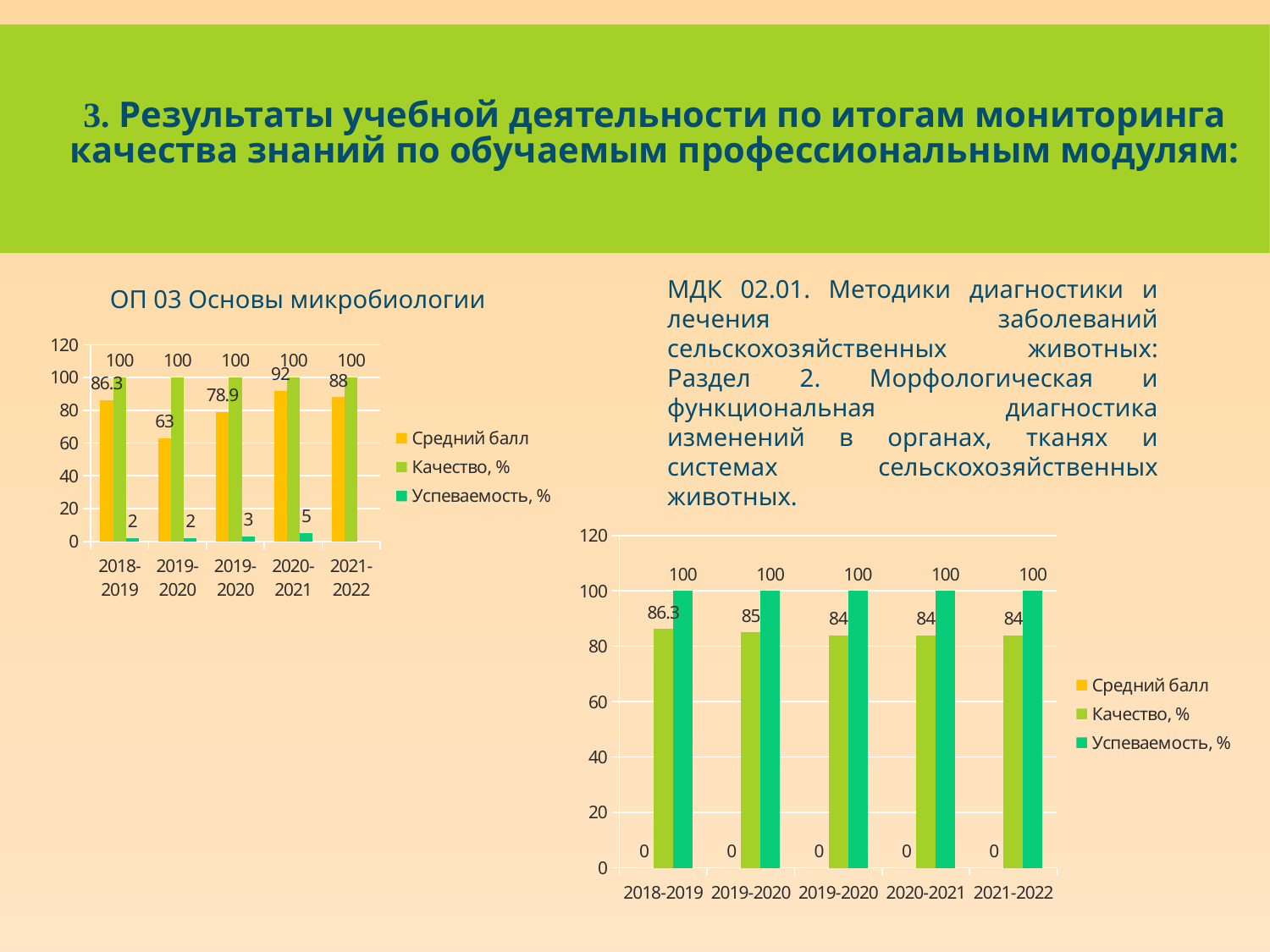
In the chart on the right side of the slide, what is the value of 'Качество, %' for 2018-2019? 86.3 In the chart on the right side of the slide, which is larger: 'Качество, %' for 2018-2019 or for 2021-2022? 2018-2019 In the chart titled 'ОП 03 Основы микробиологии', what is the difference between 'Средний балл' for 2020-2021 and for 2021-2022? 4 In the chart titled 'ОП 03 Основы микробиологии', how many series does the legend list? 3 In the chart on the right side of the slide, how many periods are shown on the x axis? 5 In the chart on the right side of the slide, what is the value of 'Успеваемость, %' for 2021-2022? 100 In the chart on the right side of the slide, what is the value of 'Средний балл' for 2018-2019? 0 In the chart titled 'ОП 03 Основы микробиологии', what is the value of 'Успеваемость, %' for 2020-2021? 5 What type of chart is the chart titled 'ОП 03 Основы микробиологии'? Bar chart In the chart titled 'ОП 03 Основы микробиологии', what is the value of 'Средний балл' for 2020-2021? 92 In the chart titled 'ОП 03 Основы микробиологии', what is the value of 'Средний балл' for 2018-2019? 86.3 In the chart titled 'ОП 03 Основы микробиологии', which period has the highest 'Средний балл'? 2020-2021